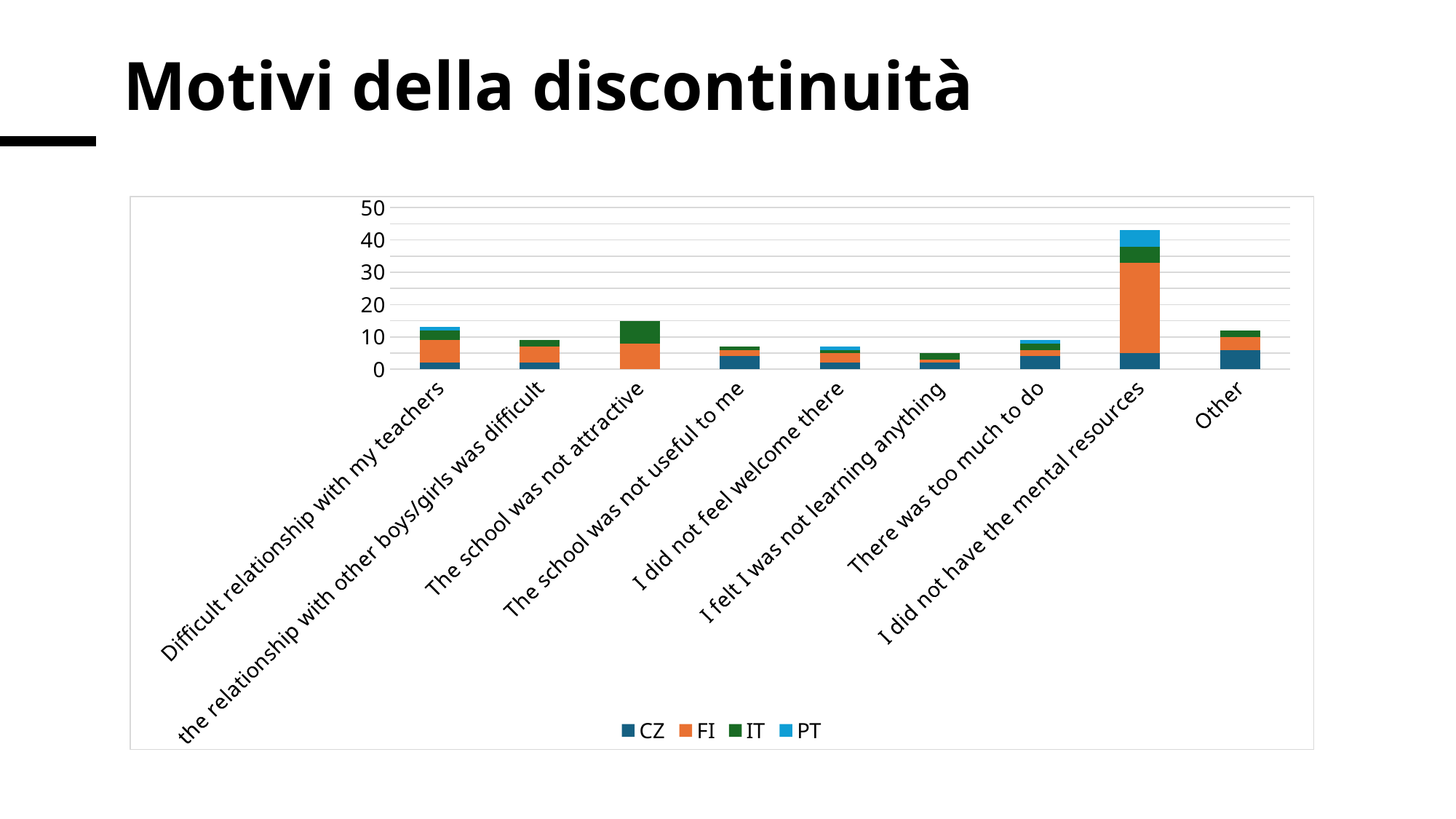
What kind of chart is shown on the slide? Stacked bar chart How many series does the legend list? 4 Is the total stacked value for 'I felt I was not learning anything' greater or less than 10? less Which category has the tallest stacked bar? I did not have the mental resources Which has the larger total stacked value: 'The school was not attractive' or 'I felt I was not learning anything'? The school was not attractive How many categories are shown on the x axis? 9 What is the title of the slide containing the chart? Motivi della discontinuità Is the total stacked value for 'The school was not attractive' greater or less than 10? greater Is the total stacked value for 'I did not have the mental resources' greater or less than 30? greater Which has the larger total stacked value: 'I did not have the mental resources' or 'Other'? I did not have the mental resources Which category has the shortest stacked bar? I felt I was not learning anything